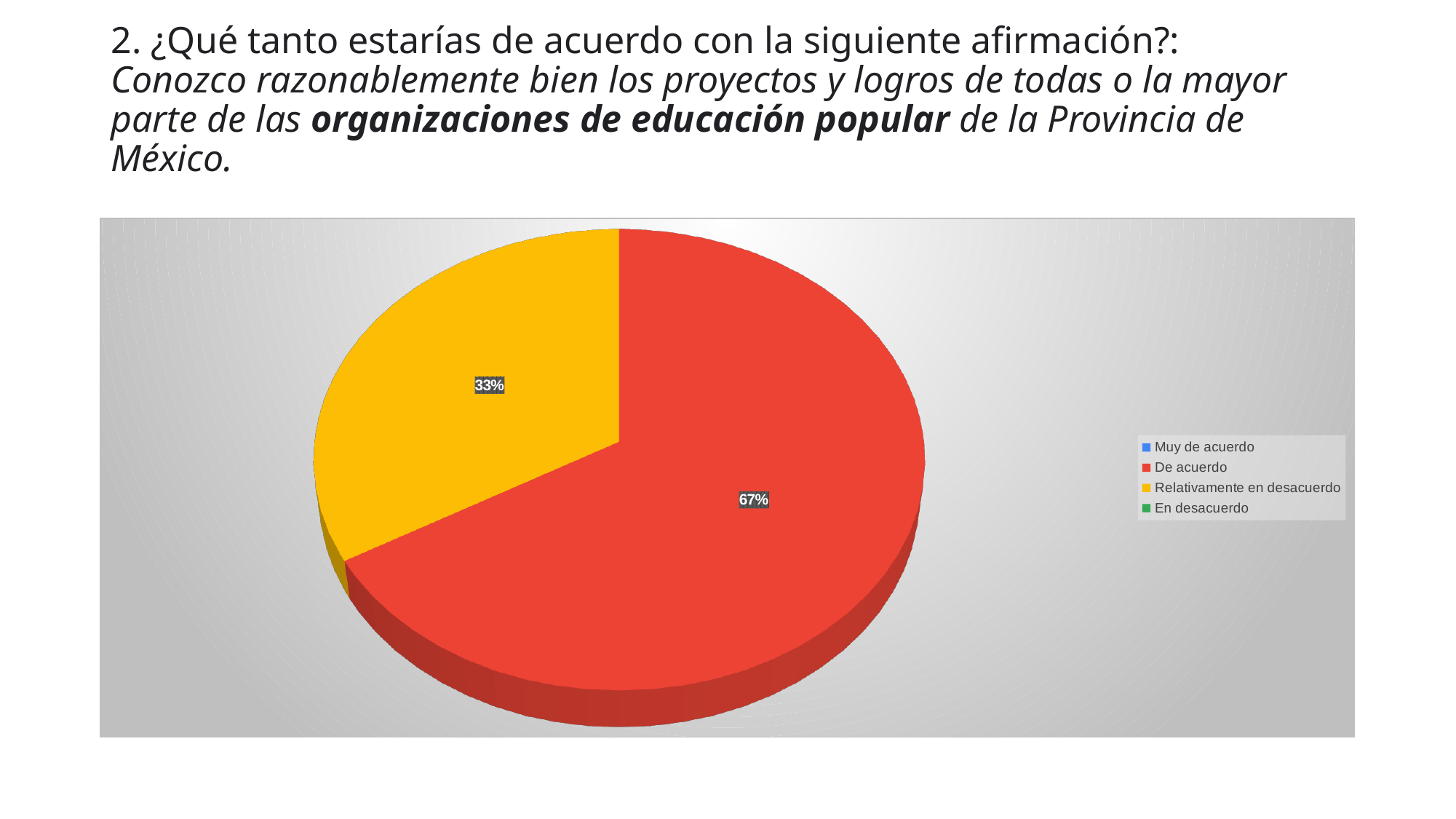
What colour is the "Relativamente en desacuerdo" slice? Yellow How many categories does the legend list? 4 What share of the pie does "Relativamente en desacuerdo" represent? 33% What is the difference in percentage points between the "De acuerdo" slice and the "Relativamente en desacuerdo" slice? 34% What share of the pie does "De acuerdo" represent? 67% Is the share for "De acuerdo" greater or less than 50%? greater What colour is the "De acuerdo" slice? Red How many slices are visible in the pie? 2 What kind of chart is shown on the slide? Pie chart Which is larger, the slice for "De acuerdo" or the slice for "Relativamente en desacuerdo"? De acuerdo Which category has the largest slice of the pie? De acuerdo